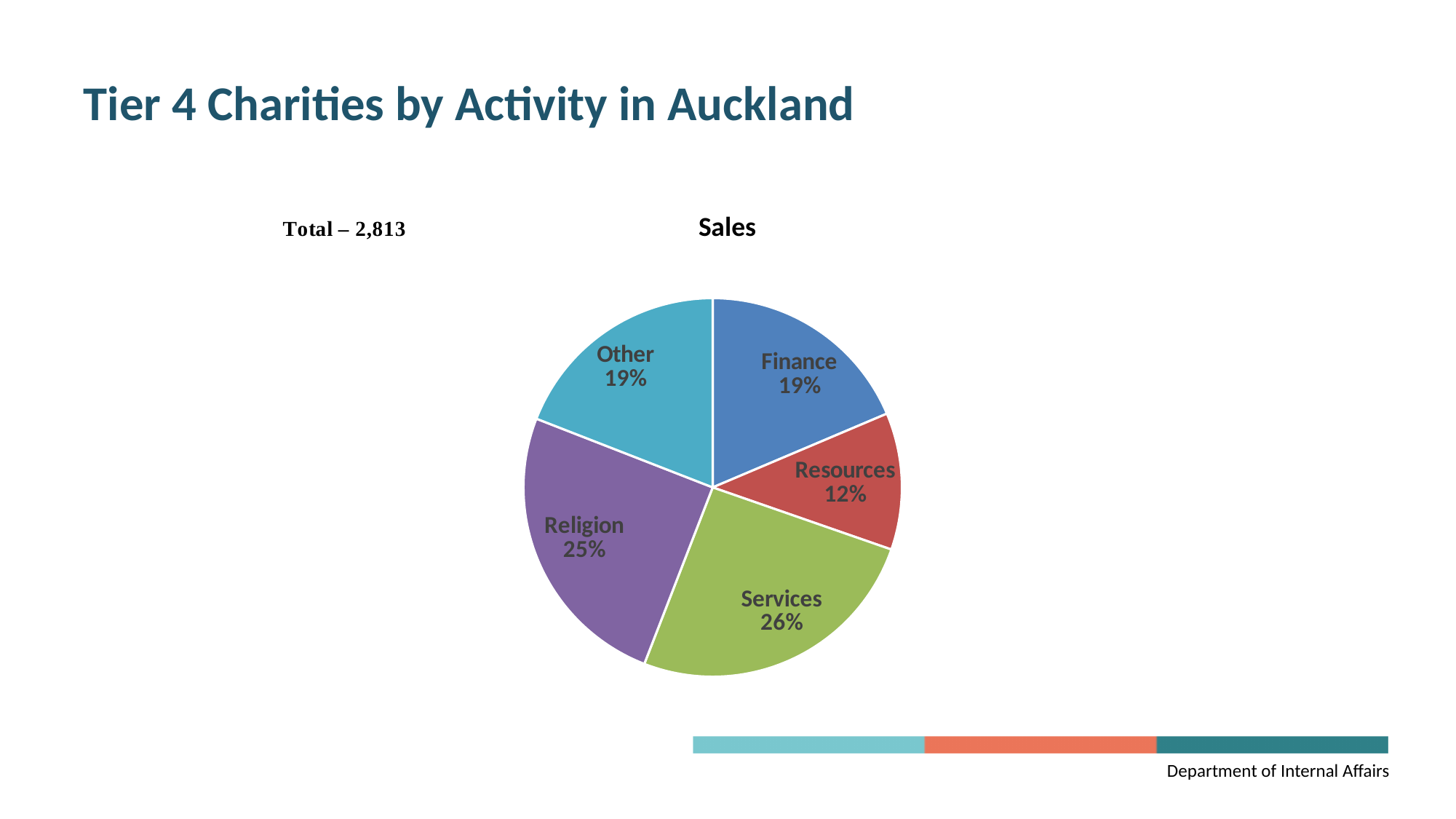
Which is larger, the share for Religion or the share for Other? Religion How many categories are shown in the pie chart? 5 What is the title shown above the pie chart? Sales What kind of chart is shown on the slide? Pie chart What percentage of the pie does Resources account for? 12% What percentage of the pie does Religion account for? 25% Which category has the smallest share of the pie? Resources Which category has the largest share of the pie? Services What total is stated on the slide next to the chart? 2,813 What percentage of the pie does Finance account for? 19% What is the difference in percentage points between Services and Resources? 14 What percentage of the pie does Services account for? 26%